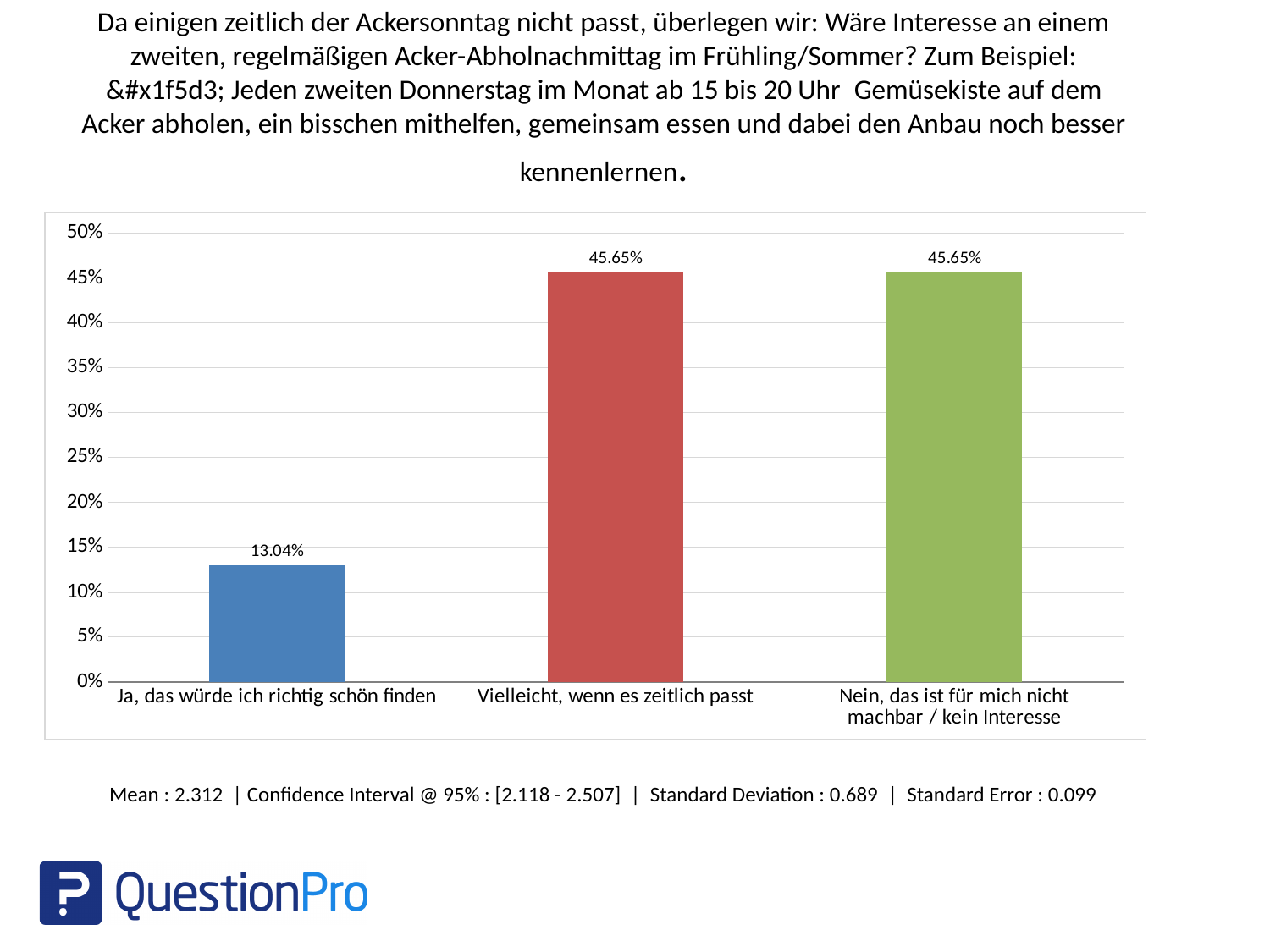
Is the value for "Vielleicht, wenn es zeitlich passt" greater or less than 40%? greater What is the value for "Ja, das würde ich richtig schön finden"? 13.04% Which is larger: the value for "Ja, das würde ich richtig schön finden" or the value for "Nein, das ist für mich nicht machbar / kein Interesse"? Nein, das ist für mich nicht machbar / kein Interesse What is the value for "Nein, das ist für mich nicht machbar / kein Interesse"? 45.65% What is the mean value reported below the chart? 2.312 What is the value for "Vielleicht, wenn es zeitlich passt"? 45.65% Which category has the lowest value? Ja, das würde ich richtig schön finden What colour is the bar for "Vielleicht, wenn es zeitlich passt"? Red What kind of chart is shown on the slide? Bar chart Is the value for "Ja, das würde ich richtig schön finden" greater or less than 15%? less How many categories are shown in the chart? 3 What is the difference between the values for "Vielleicht, wenn es zeitlich passt" and "Ja, das würde ich richtig schön finden"? 32.61%